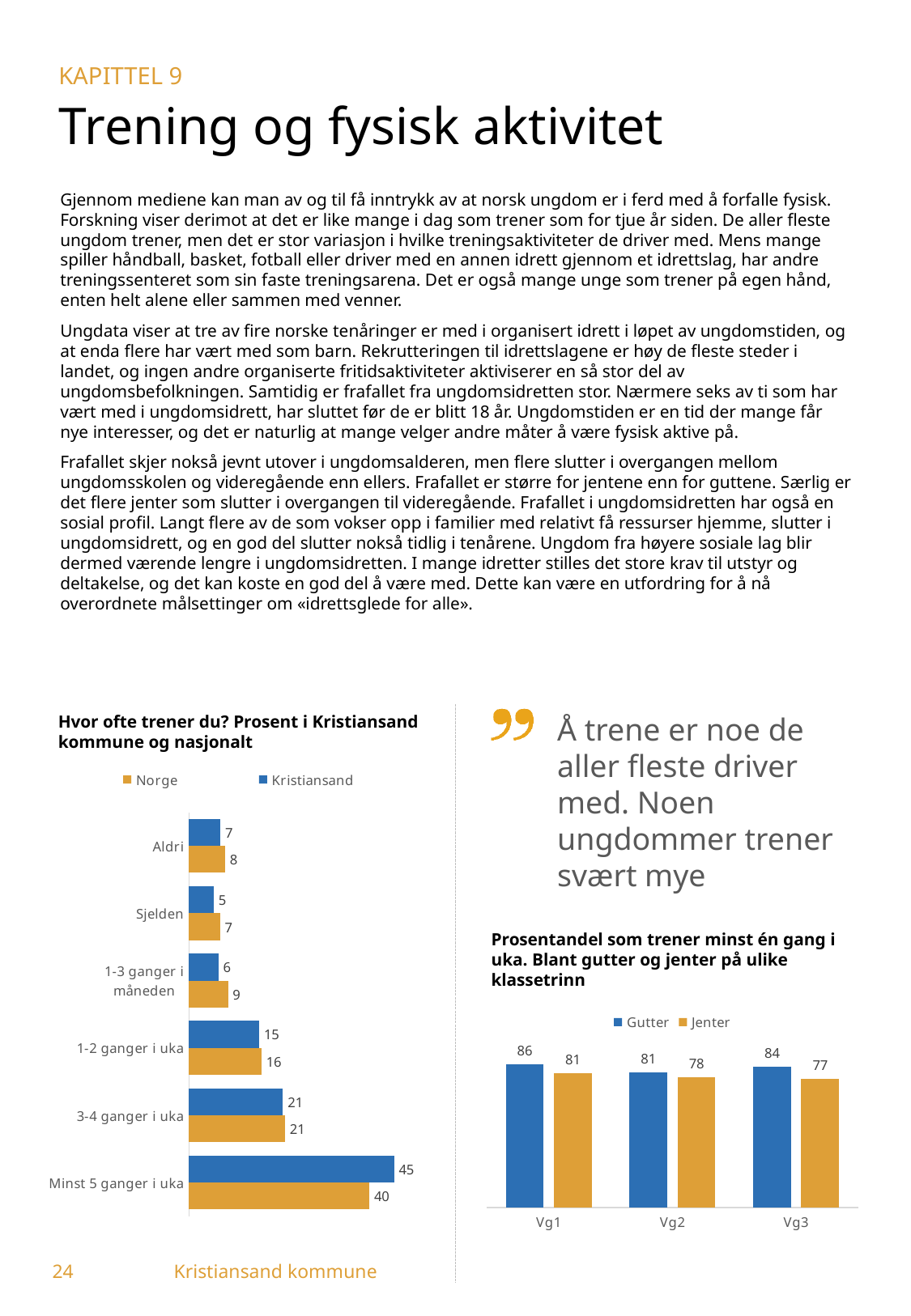
In the chart 'Hvor ofte trener du?', which category has the lowest value for Kristiansand? Sjelden In the chart 'Hvor ofte trener du?', what is the value for Norge in the category 'Sjelden'? 7 In the chart 'Hvor ofte trener du?', which category has the highest value for Kristiansand? Minst 5 ganger i uka What kind of chart is 'Prosentandel som trener minst én gang i uka'? Bar chart In the chart 'Prosentandel som trener minst én gang i uka', which class level has the highest value for Gutter? Vg1 In the chart 'Prosentandel som trener minst én gang i uka', which is larger at Vg1, Gutter or Jenter? Gutter In the chart 'Hvor ofte trener du?', how many series does the legend list? 2 In the chart 'Hvor ofte trener du?', what is the value for Kristiansand in the category 'Minst 5 ganger i uka'? 45 In the chart 'Prosentandel som trener minst én gang i uka', what is the value for Jenter at Vg2? 78 In the chart 'Prosentandel som trener minst én gang i uka', what is the difference between Gutter and Jenter at Vg3? 7 In the chart 'Hvor ofte trener du?', what is the difference between Kristiansand and Norge in the category 'Minst 5 ganger i uka'? 5 In the chart 'Hvor ofte trener du?', how many categories are shown? 6